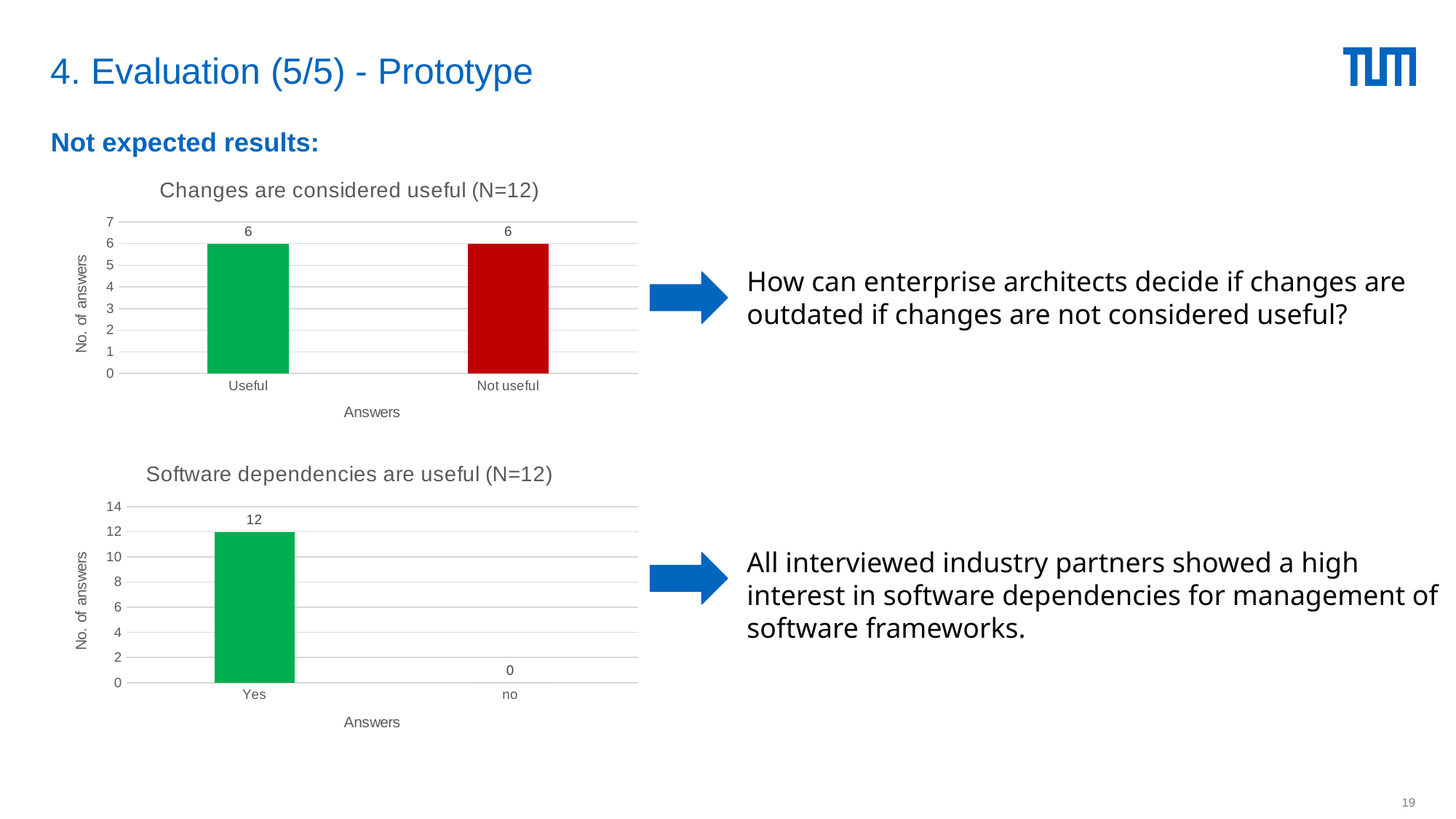
In the chart titled "Changes are considered useful (N=12)", what is the difference between the values for "Useful" and "Not useful"? 0 In the chart titled "Changes are considered useful (N=12)", what is the label of the y axis? No. of answers In the chart titled "Software dependencies are useful (N=12)", what is the value for "Yes"? 12 In the chart titled "Changes are considered useful (N=12)", what is the value for "Useful"? 6 What kind of chart is the chart titled "Software dependencies are useful (N=12)"? Bar chart In the chart titled "Software dependencies are useful (N=12)", which category has the highest value? Yes In the chart titled "Software dependencies are useful (N=12)", what is the value for "no"? 0 How many categories are shown in the chart titled "Changes are considered useful (N=12)"? 2 In the chart titled "Changes are considered useful (N=12)", what is the value for "Not useful"? 6 In the chart titled "Software dependencies are useful (N=12)", which category has the lowest value? no In the chart titled "Software dependencies are useful (N=12)", what is the difference between the values for "Yes" and "no"? 12 In the chart titled "Changes are considered useful (N=12)", what colour is the bar for "Not useful"? Red